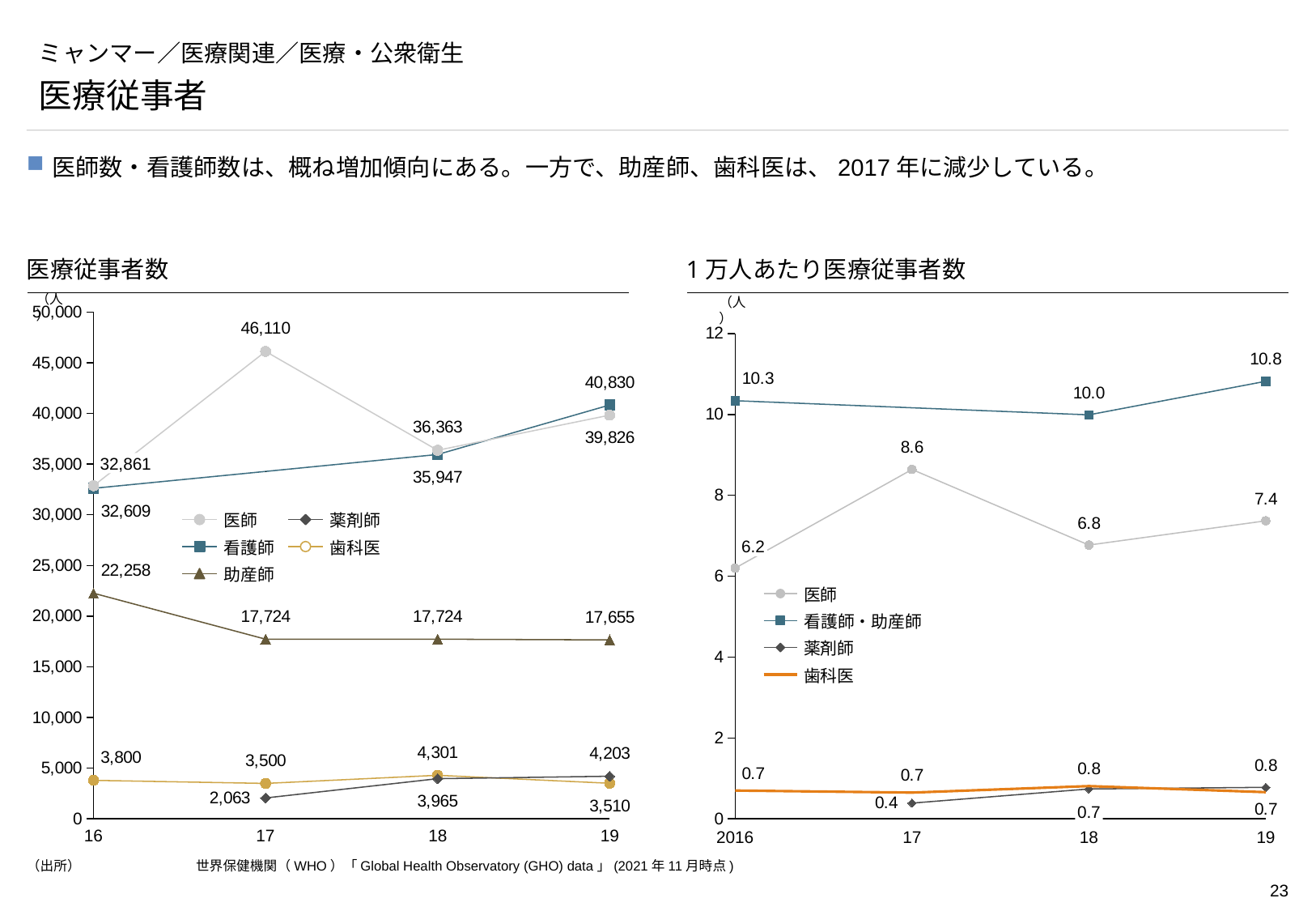
In the left chart (医療従事者数), in which year is the value for 医師 highest? 17 In the left chart (医療従事者数), is the value for 看護師 in 17 greater or less than 30,000? greater In the left chart (医療従事者数), what is the value for 医師 in 17? 46,110 What type of chart is the right chart (1万人あたり医療従事者数)? line chart In the left chart (医療従事者数), what is the value for 看護師 in 19? 40,830 In the left chart (医療従事者数), what is the difference between the 助産師 values in 16 and 17? 4,534 In the left chart (医療従事者数), what is the value for 助産師 in 16? 22,258 In the left chart (医療従事者数), how many series does the legend list? 5 In the right chart (1万人あたり医療従事者数), which is larger in 18: 医師 or 看護師・助産師? 看護師・助産師 In the right chart (1万人あたり医療従事者数), what is the value for 医師 in 2016? 6.2 In the right chart (1万人あたり医療従事者数), what is the value for 看護師・助産師 in 19? 10.8 In the left chart (医療従事者数), what is the value for 薬剤師 in 17? 2,063